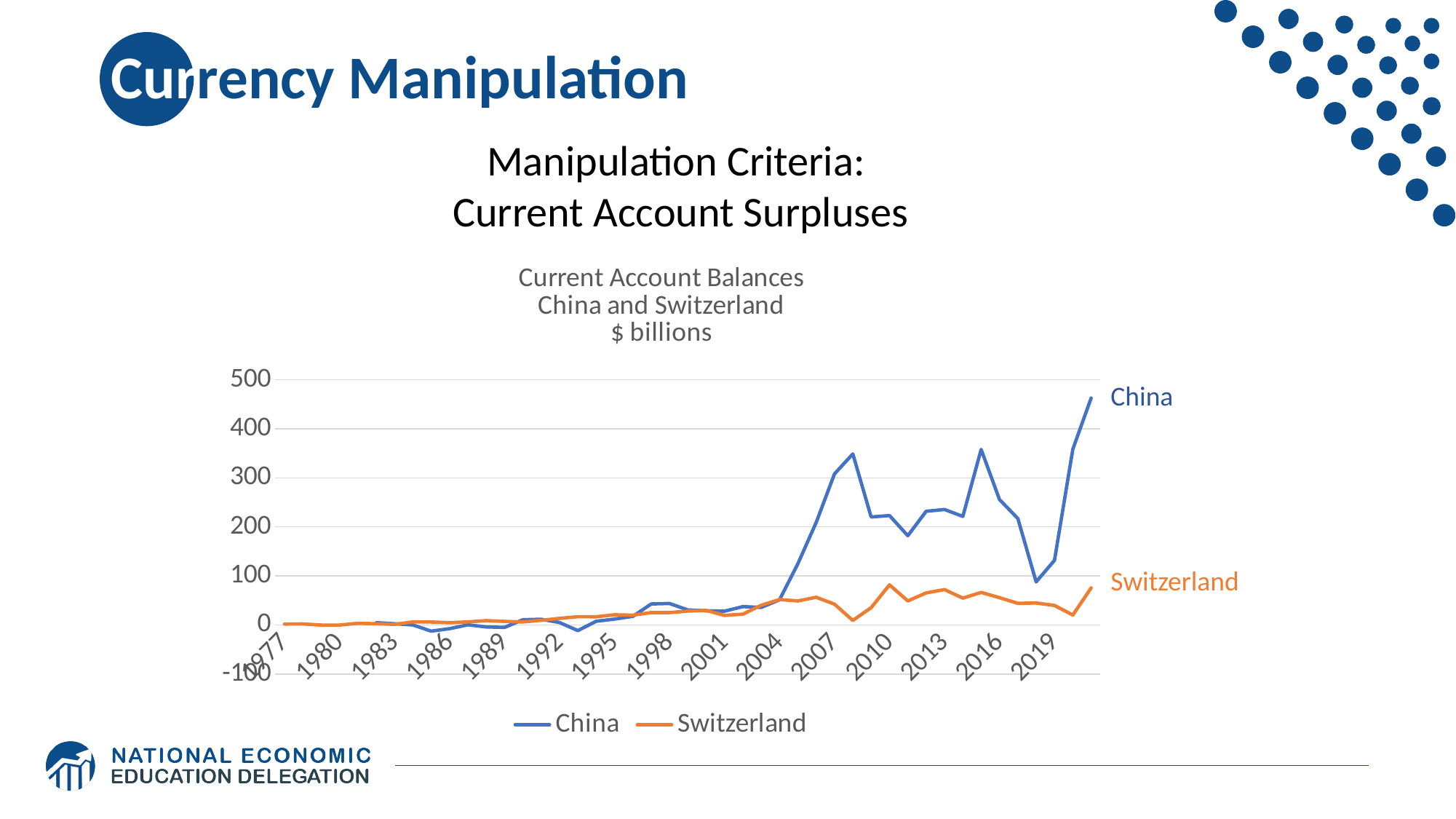
At the right end of the chart, which series has the larger value, China or Switzerland? China Is the highest point of the China line greater or less than 400? greater Which series reaches the highest value on the chart? China What unit is given in the chart title? $ billions What kind of chart is shown on the slide? line chart Which two countries are plotted in the chart? China and Switzerland How many year labels are shown on the x axis? 15 How many series does the legend list? 2 Is the highest point of the Switzerland line greater or less than 100? less Is the value for China in 2004 greater or less than 100? less Does the China line overall rise or fall from 1977 to the end of the series? rise